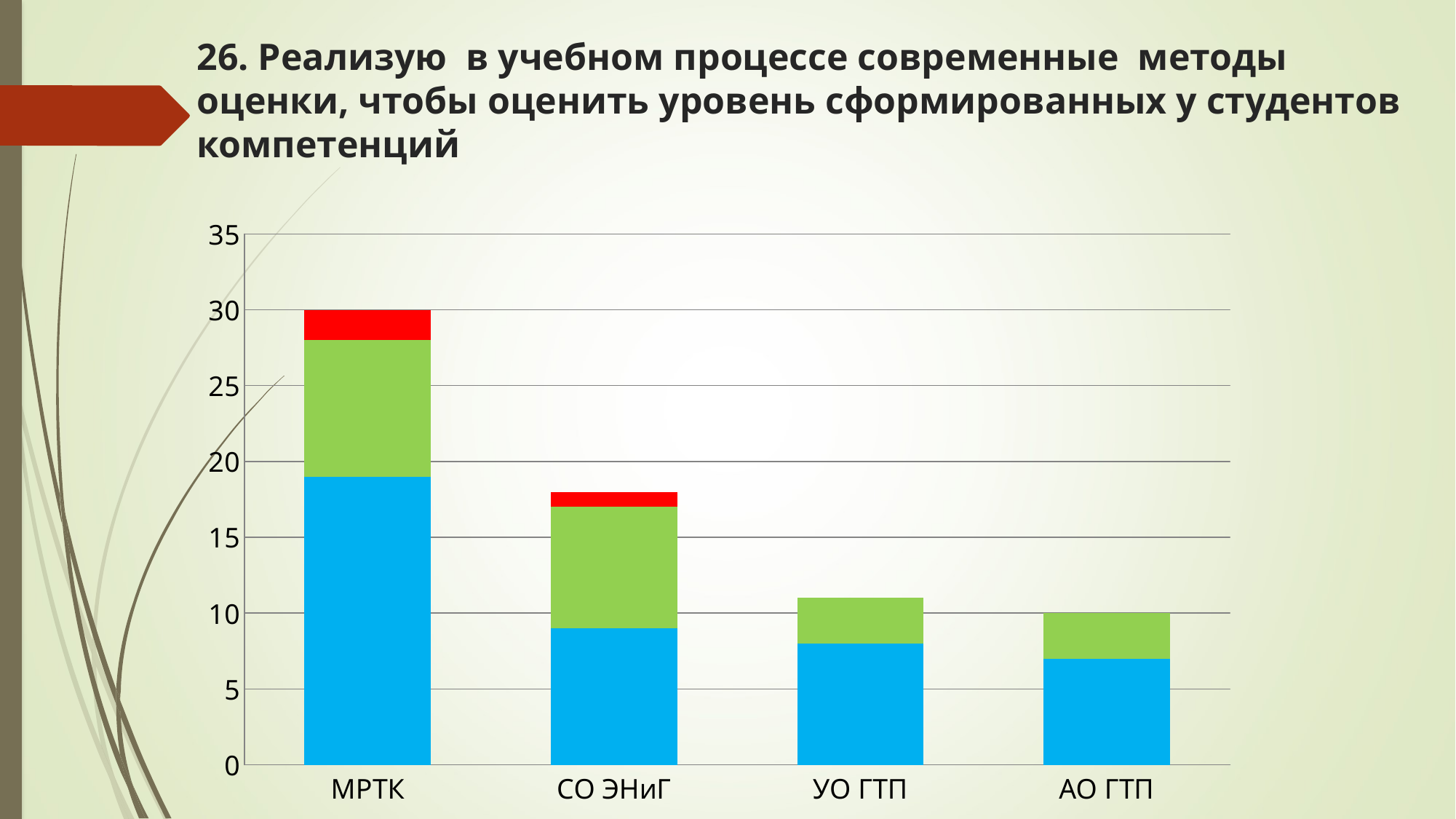
Do the total bar heights rise or fall from left to right across the categories? fall What is the difference between the total bar heights for МРТК and АО ГТП? 20 How many categories are shown on the x axis of the chart? 4 What is the total height of the stacked bar for МРТК? 30 Which stacked bar is taller, МРТК or СО ЭНиГ? МРТК Which category has the tallest stacked bar? МРТК What is the total height of the stacked bar for АО ГТП? 10 Which categories have a red segment at the top of their bar? МРТК and СО ЭНиГ What kind of chart is shown on the slide? bar chart Is the total bar height for СО ЭНиГ greater or less than 15? greater Is the total bar height for УО ГТП greater or less than 15? less Is the blue segment for МРТК greater or less than 15? greater